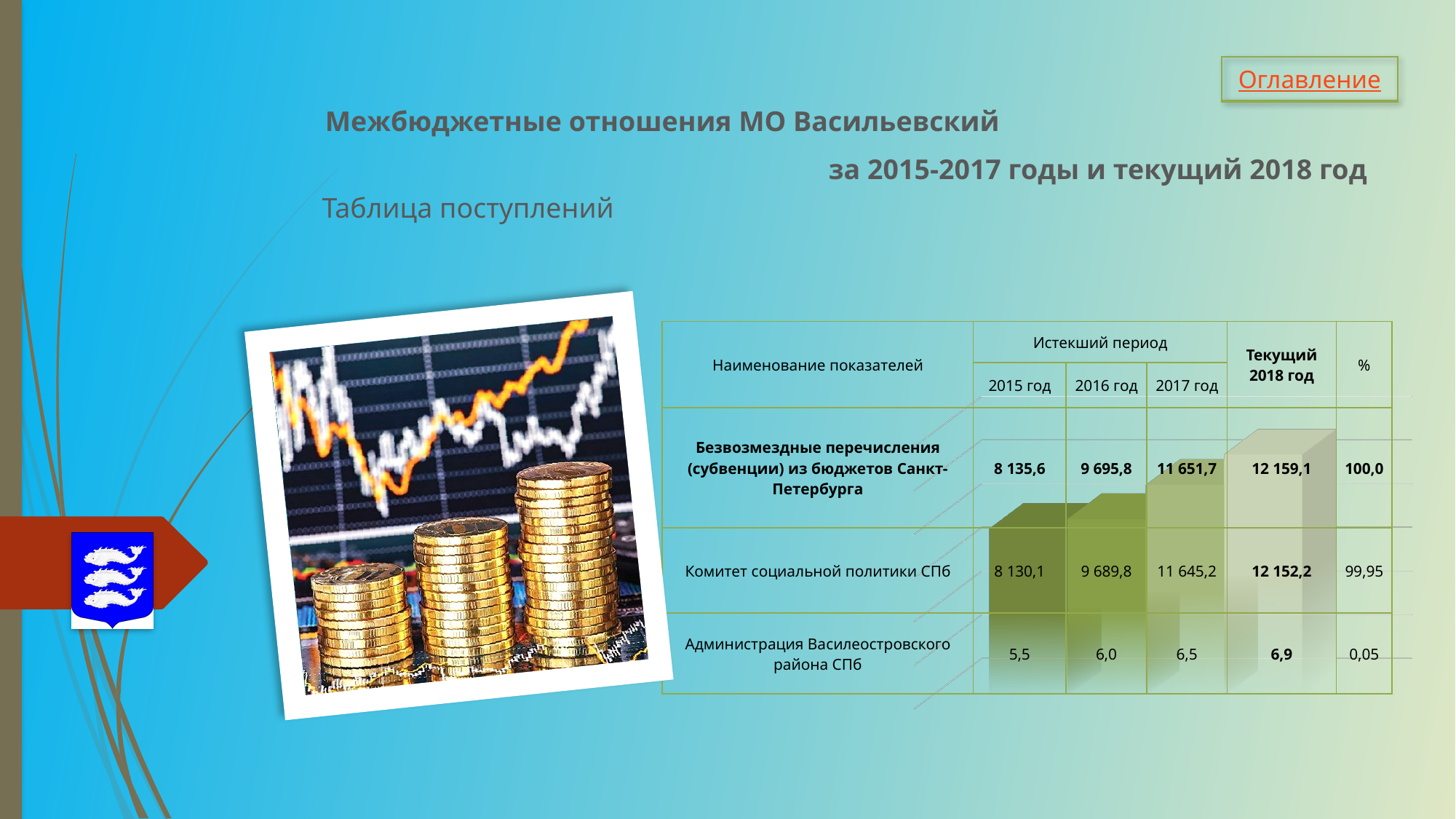
What is the value of Безвозмездные перечисления (субвенции) из бюджетов Санкт-Петербурга for 2015 год? 8 135,6 Which year has the lowest value for Администрация Василеостровского района СПб? 2015 год Do the bars in the chart behind the table rise or fall from left to right? rise What is the value for Комитет социальной политики СПб in 2017 год? 11 645,2 What is the difference between the 2018 and 2017 values of Безвозмездные перечисления (субвенции) из бюджетов Санкт-Петербурга? 507,4 What kind of chart is drawn behind the table on the slide? bar chart What is the value of Безвозмездные перечисления (субвенции) из бюджетов Санкт-Петербурга for Текущий 2018 год? 12 159,1 How many bars does the chart behind the table show? 4 Which year has the highest value of Безвозмездные перечисления (субвенции) из бюджетов Санкт-Петербурга? Текущий 2018 год What is the value for Администрация Василеостровского района СПб in 2016 год? 6,0 What percentage (%) is shown for Комитет социальной политики СПб? 99,95 Which is larger for Комитет социальной политики СПб: the 2016 год value or the 2017 год value? 2017 год